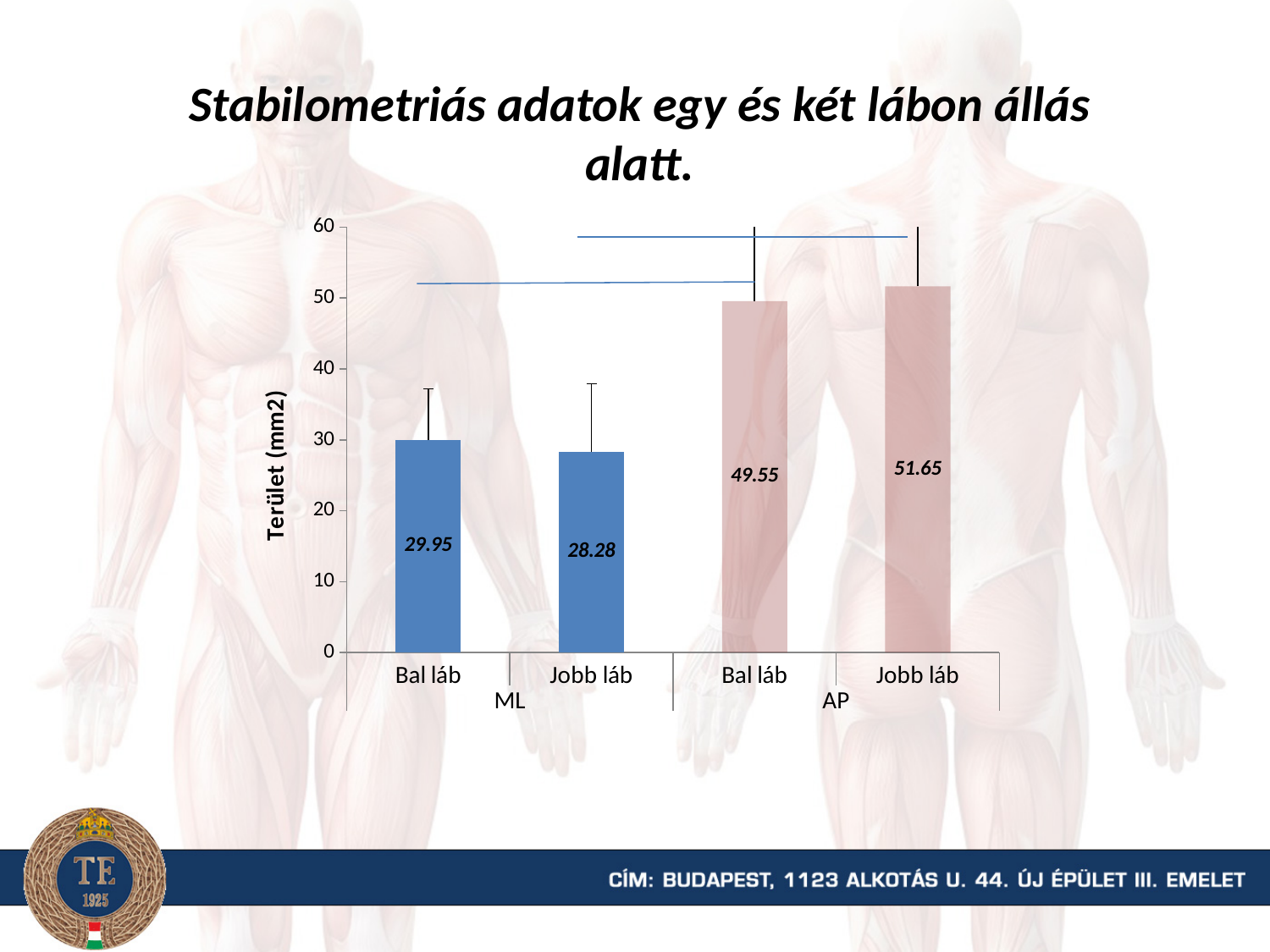
Which is larger, the AP Bal láb value or the ML Bal láb value? AP Bal láb What is the value for Bal láb in the AP group? 49.55 Which bar has the lowest value? Jobb láb (ML) Which bar has the highest value? Jobb láb (AP) What kind of chart is shown on the slide? Bar chart What is the difference between the AP Jobb láb value and the AP Bal láb value? 2.1 What is the value for Bal láb in the ML group? 29.95 What is the difference between the ML Bal láb value and the ML Jobb láb value? 1.67 What is the label of the vertical axis? Terület (mm2) How many bars are plotted in the chart? 4 What is the value for Jobb láb in the ML group? 28.28 What is the value for Jobb láb in the AP group? 51.65